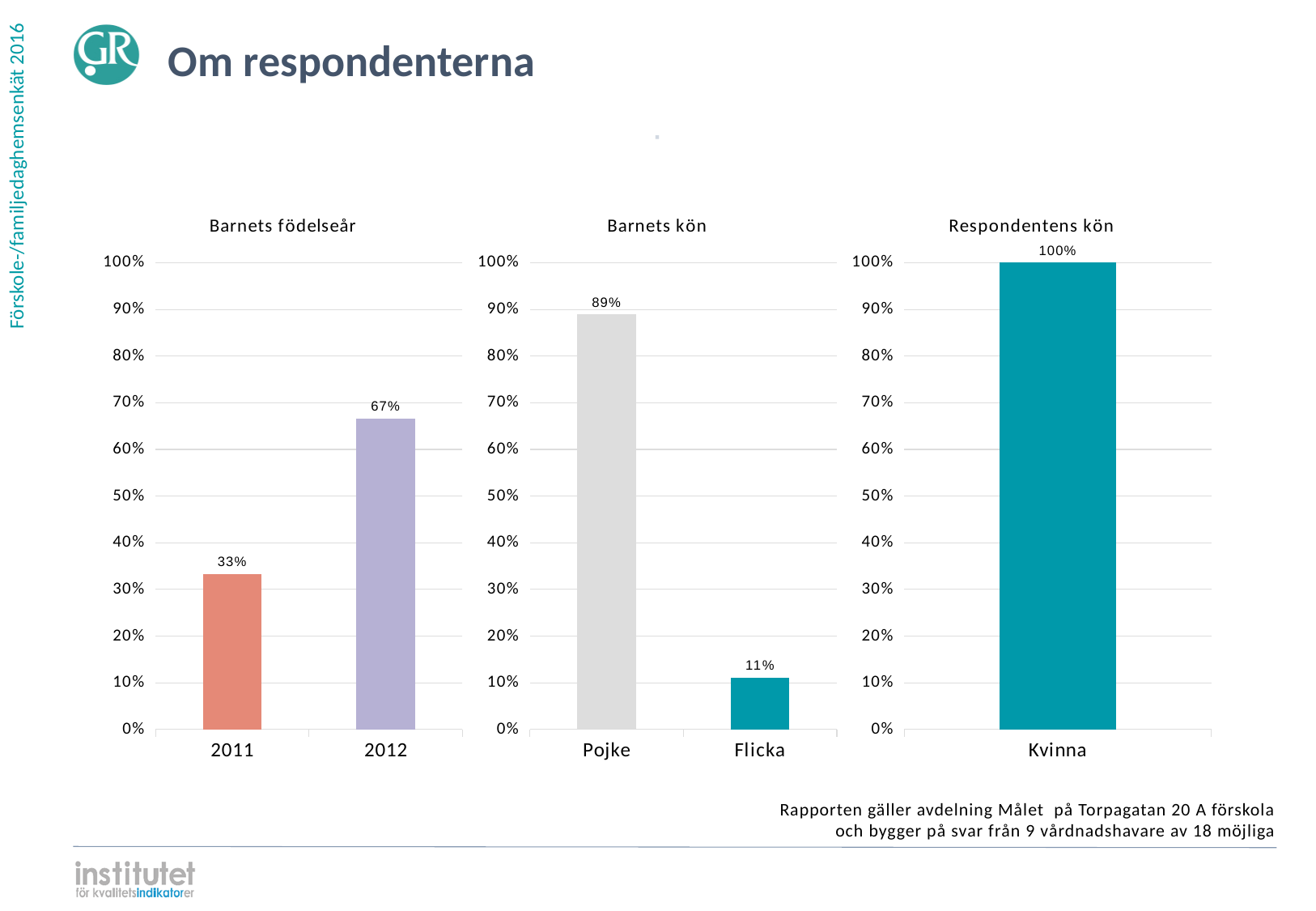
In the 'Barnets födelseår' chart, which category has the highest value? 2012 In the 'Barnets kön' chart, what is the value for Pojke? 89% In the 'Barnets födelseår' chart, what is the value for 2012? 67% How many categories are shown in the 'Respondentens kön' chart? 1 How many charts are shown on the slide? 3 What kind of chart is the 'Barnets kön' chart? Bar chart In the 'Barnets kön' chart, which category has the lowest value? Flicka In the 'Barnets kön' chart, is the value for Pojke greater or less than 80%? greater In the 'Barnets kön' chart, what is the value for Flicka? 11% In the 'Respondentens kön' chart, what is the value for Kvinna? 100% In the 'Barnets födelseår' chart, what is the difference between the values for 2012 and 2011? 34% In the 'Barnets födelseår' chart, what is the value for 2011? 33%